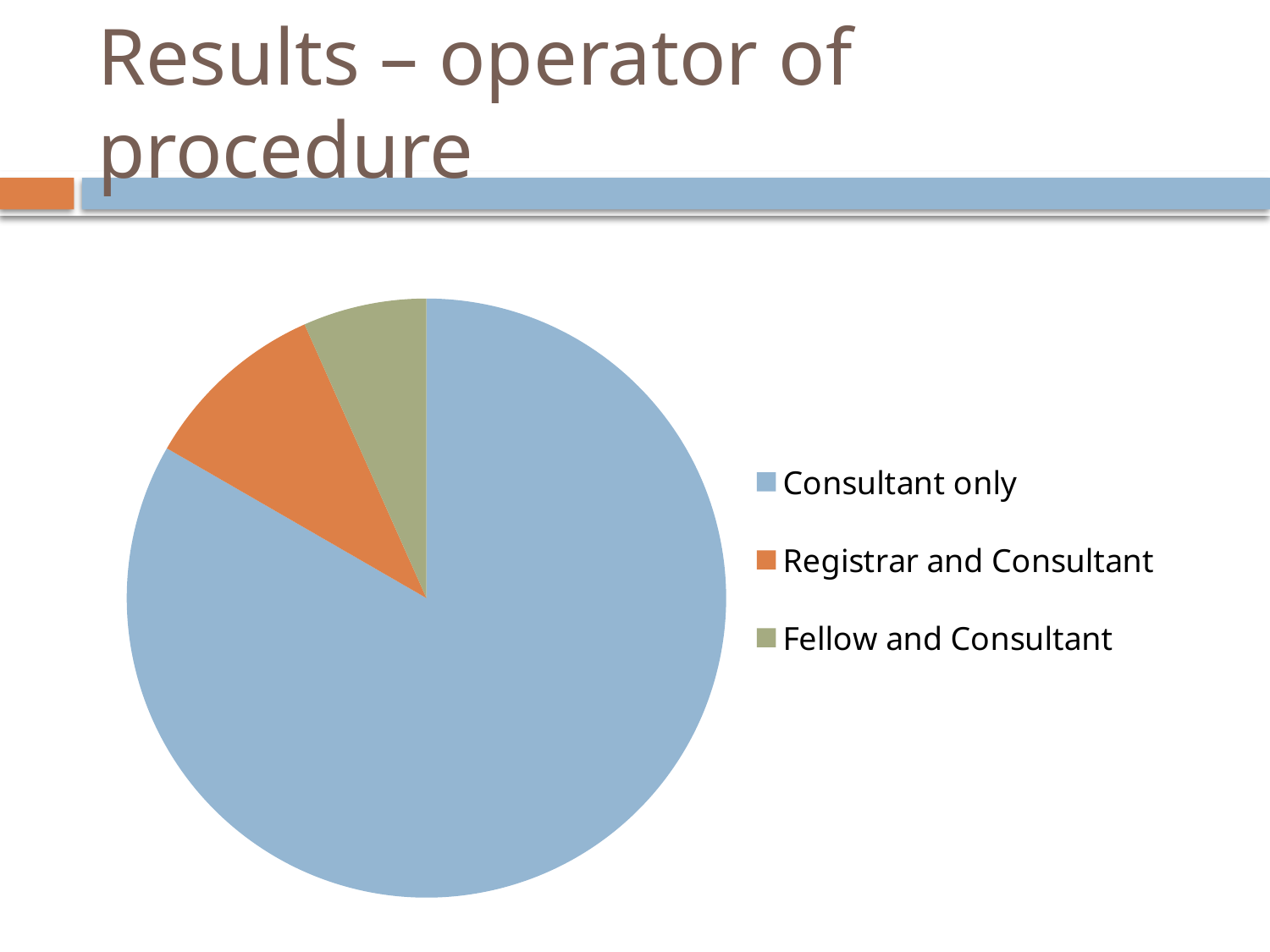
Which slice is larger: Registrar and Consultant or Fellow and Consultant? Registrar and Consultant Which category has the largest slice of the pie chart? Consultant only Does the Consultant only slice make up more or less than half of the pie chart? More How many slices does the pie chart have? 3 What is the title of the slide containing the pie chart? Results – operator of procedure Which slice is larger: Consultant only or Registrar and Consultant? Consultant only Which category has the smallest slice of the pie chart? Fellow and Consultant What colour is the Registrar and Consultant slice in the pie chart? Orange How many entries does the legend of the pie chart list? 3 What kind of chart is shown on the slide? Pie chart